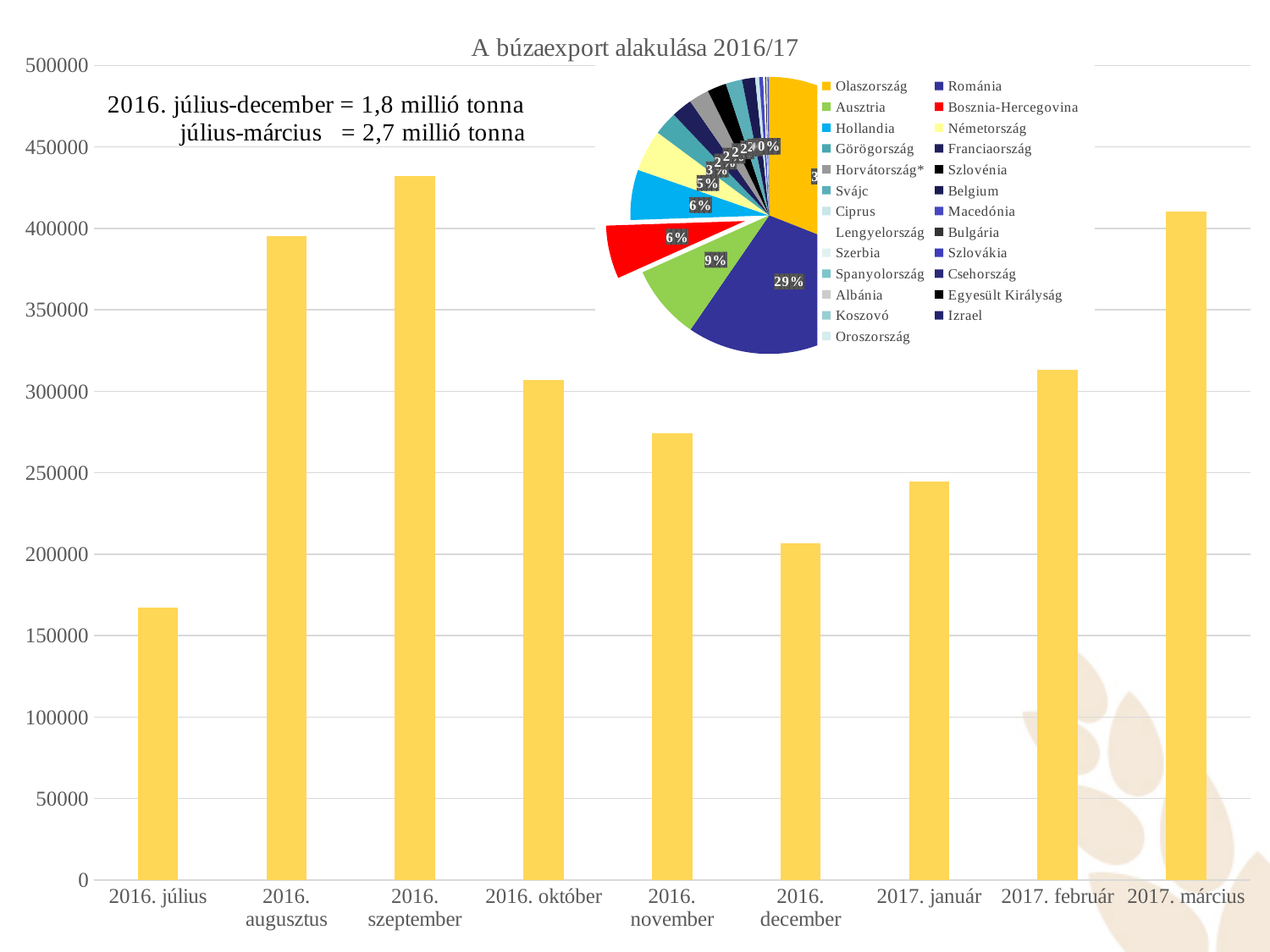
In the bar chart, which is larger, the value for 2016. november or 2017. január? 2016. november In the bar chart, is the value for 2016. július greater or less than 200000? less What kind of chart is the large chart showing monthly values on the slide? bar chart In the bar chart, is the value for 2016. november greater or less than 300000? less What is the title of the slide's chart? A búzaexport alakulása 2016/17 In the bar chart, is the value for 2016. december greater or less than 250000? less In the bar chart, do the values rise or fall from 2016. szeptember to 2016. december? fall In the bar chart, which month has the highest bar? 2016. szeptember In the pie chart, what share is labelled for Románia? 29% In the bar chart, how many months are shown on the x axis? 9 In the bar chart, which month has the lowest bar? 2016. július